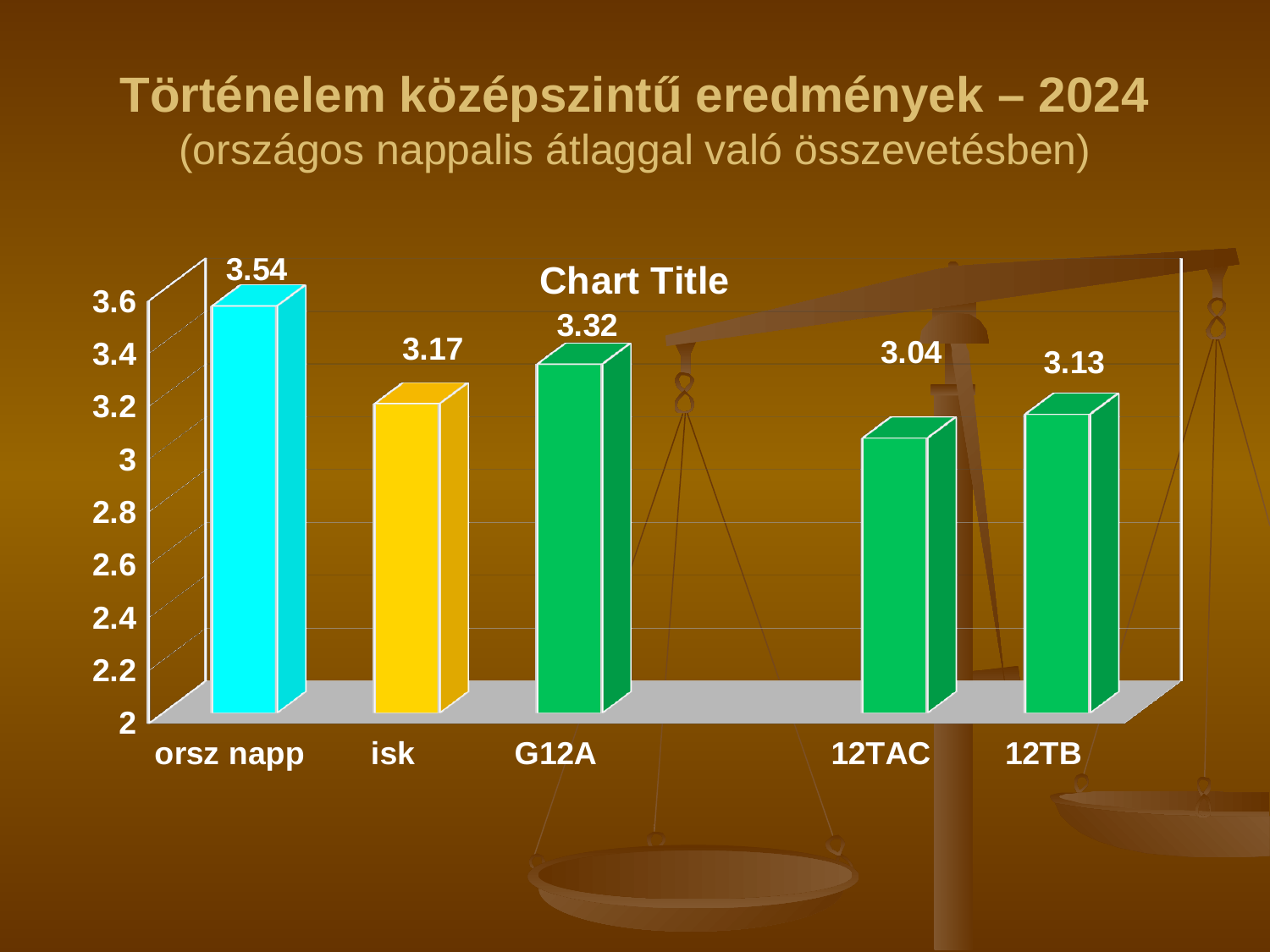
Which category has the lowest value? 12TAC What is the difference between the values for orsz napp and isk? 0.37 What is the value for G12A? 3.32 What is the value for 12TB? 3.13 What is the difference between the values for G12A and 12TAC? 0.28 Which category has the highest value? orsz napp Which is larger, the value for isk or the value for 12TB? isk What kind of chart is shown on the slide? bar chart How many labeled bars does the chart show? 5 What title is printed inside the chart area? Chart Title What is the value for orsz napp? 3.54 What is the value for 12TAC? 3.04